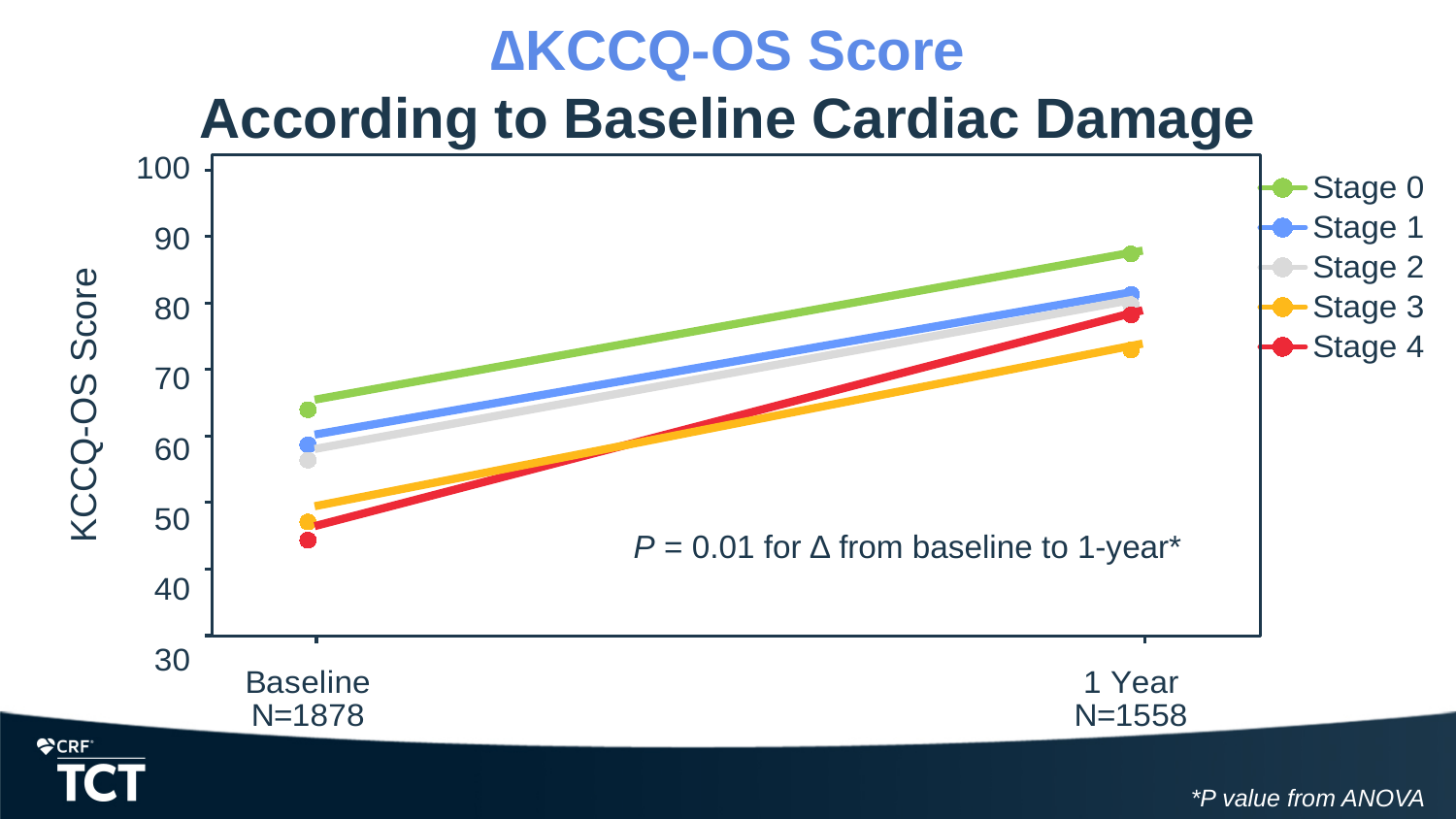
How many series does the legend list? 5 Which stage has the lowest KCCQ-OS score at 1 Year? Stage 3 Is the Baseline value for Stage 4 greater or less than 50? less How many time points are plotted along the x axis? 2 Do the KCCQ-OS scores rise or fall from Baseline to 1 Year? rise Which stage has the highest KCCQ-OS score at Baseline? Stage 0 What kind of chart is shown on the slide? line chart Which stage has the highest KCCQ-OS score at 1 Year? Stage 0 Which stage has the lowest KCCQ-OS score at Baseline? Stage 4 Is the 1 Year value for Stage 0 greater or less than 80? greater At 1 Year, which is larger: the value for Stage 0 or the value for Stage 3? Stage 0 What is the label on the y axis? KCCQ-OS Score